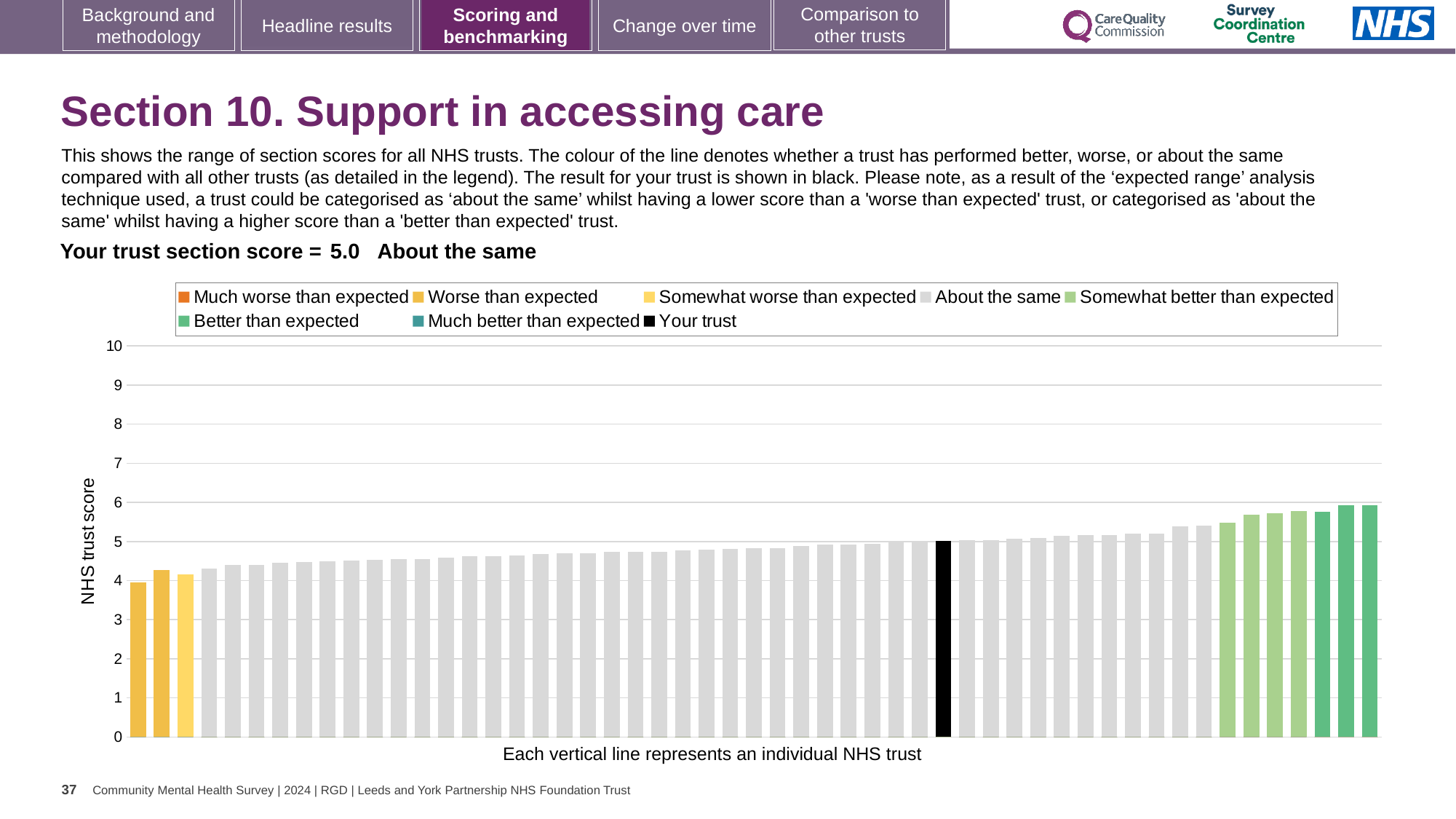
What is the section score for your trust shown on the slide? 5.0 How many entries does the chart legend list? 8 Is the value of the leftmost bar greater or less than 5? less What kind of chart is shown on the slide? Bar chart Do the bar values rise or fall from left to right along the x axis? Rise How is your trust categorised compared with other trusts on this slide? About the same What colour is the bar representing your trust? Black Is the value of the leftmost bar greater or less than 3? greater Is the value of the tallest bar greater or less than 7? less What is the label on the vertical axis of the chart? NHS trust score